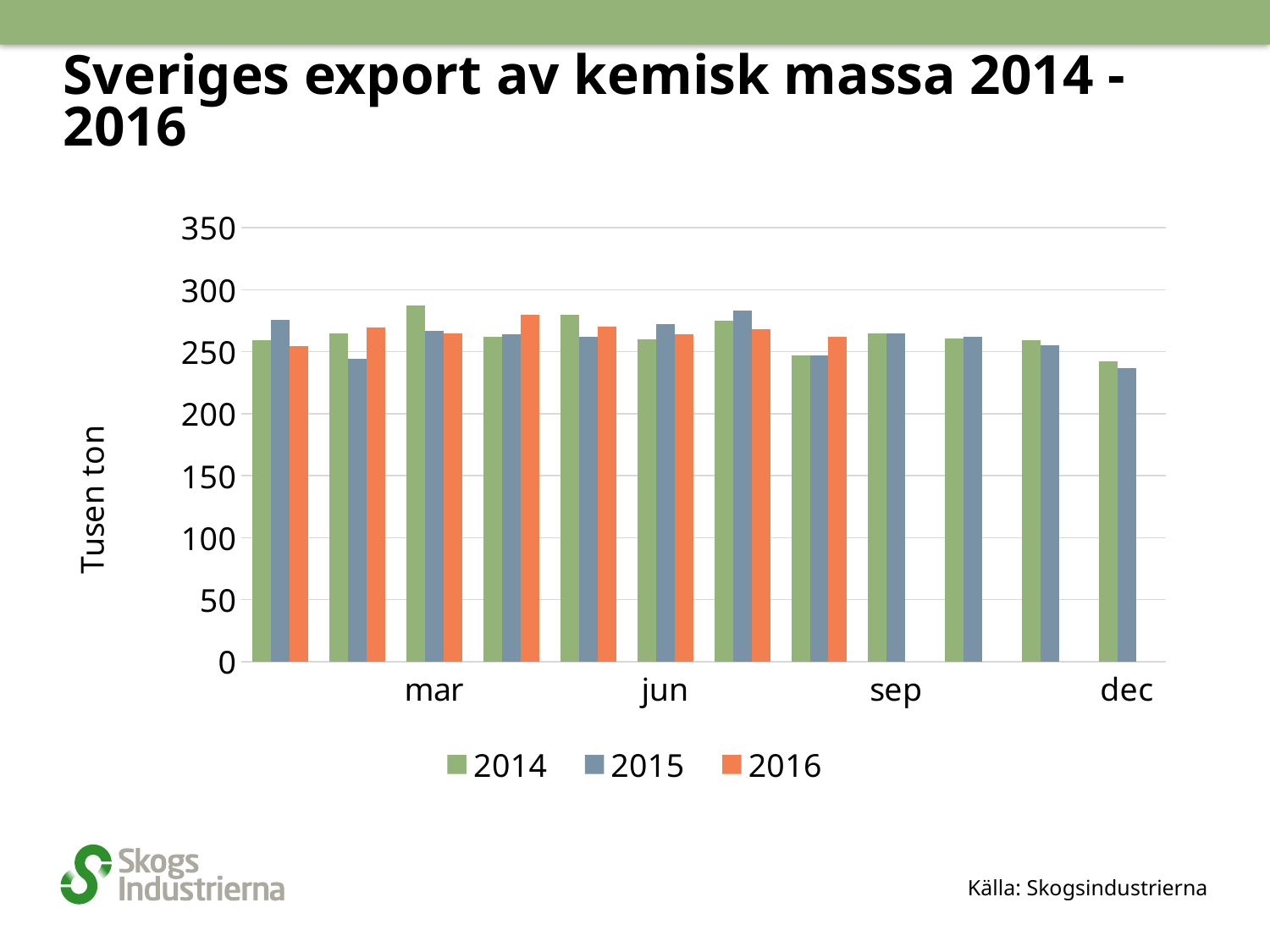
In mar, which is larger: the value for 2014 or the value for 2015? 2014 Which series has no bars for the months sep through dec? 2016 How many series does the legend list? 3 Is the value for 2016 in jun greater or less than 250? greater Is the value for 2014 in mar greater or less than 250? greater In which month is the 2014 series at its highest? mar What is the label on the vertical axis? Tusen ton Is the value for 2015 in dec greater or less than 250? less In jun, which is larger: the value for 2014 or the value for 2015? 2015 Which years are listed in the legend? 2014, 2015, 2016 What kind of chart is shown on the slide? bar chart